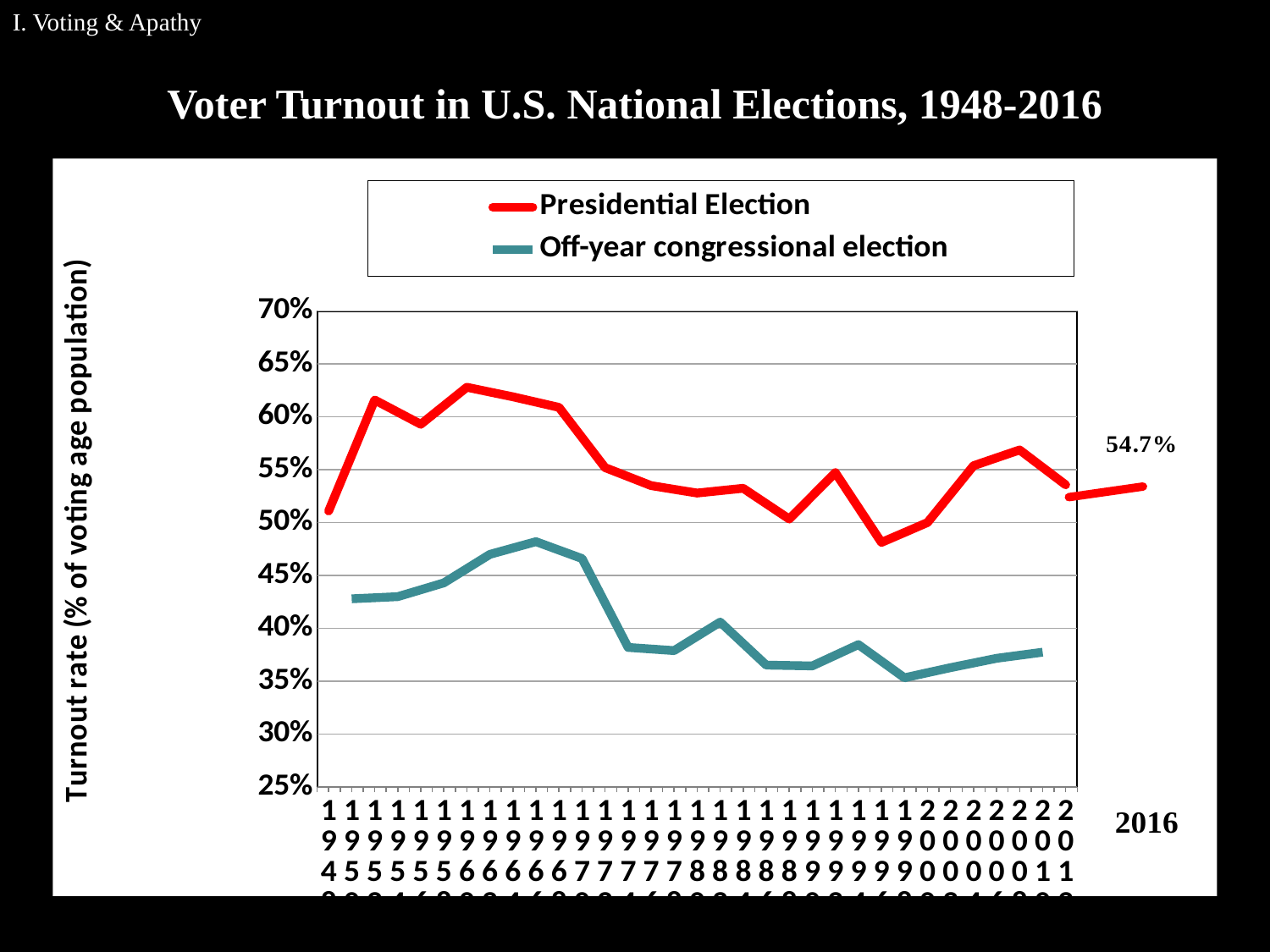
Is the lowest value of the Presidential Election line greater or less than 45%? greater What is the title of the chart? Voter Turnout in U.S. National Elections, 1948-2016 What are the two series named in the legend? Presidential Election; Off-year congressional election Which series has the higher turnout rates throughout the chart, Presidential Election or Off-year congressional election? Presidential Election Is the highest value of the Off-year congressional election line greater or less than 50%? less What turnout value is labeled on the chart for the 2016 presidential election? 54.7% Does the Off-year congressional election turnout generally rise or fall from the 1960s to the 2010s? fall Is the lowest value of the Off-year congressional election line greater or less than 40%? less What is the highest value shown on the vertical axis? 70% What kind of chart is shown on the slide? line chart How many series does the legend list? 2